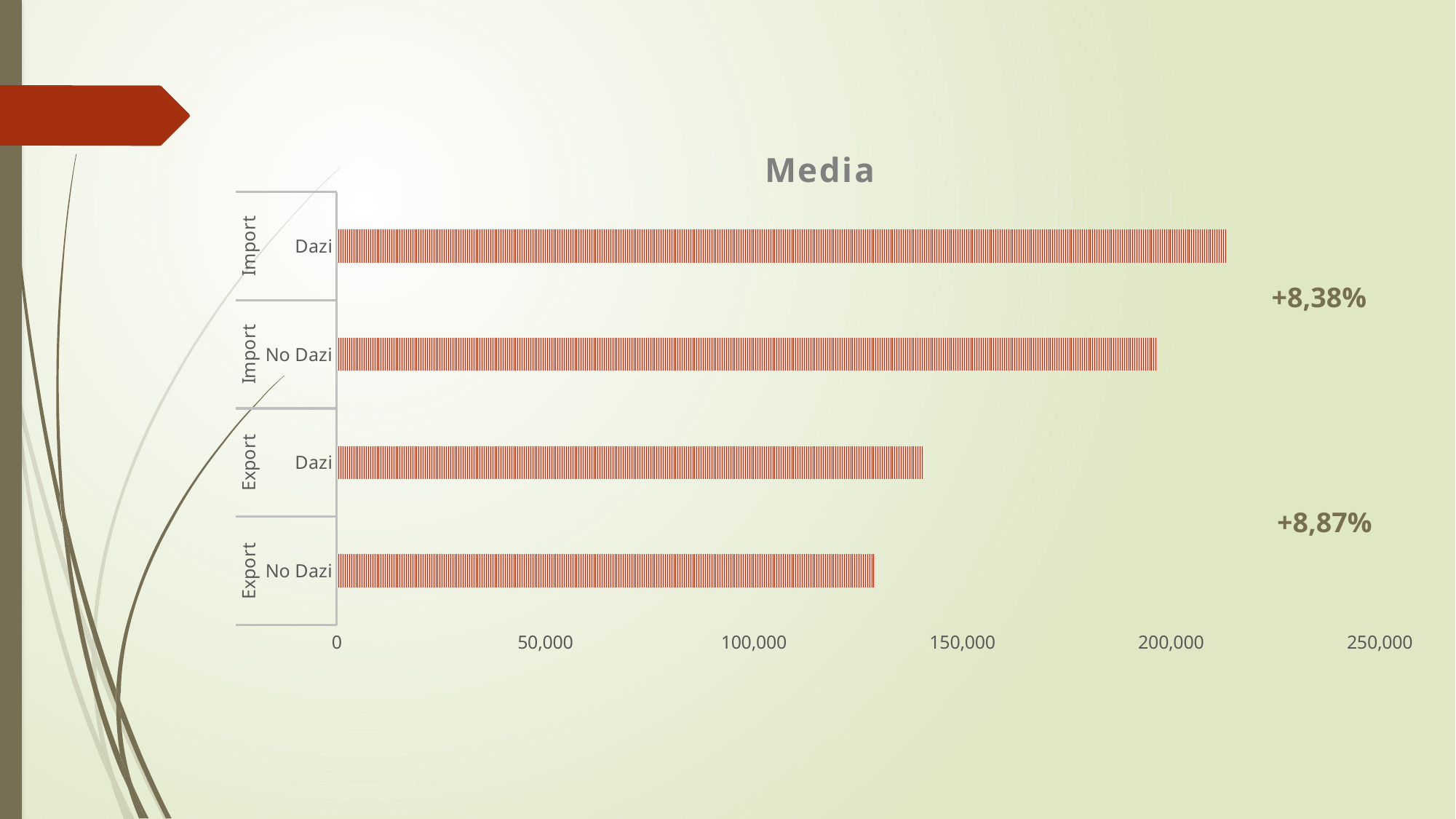
What is the title of the chart? Media Which category has the highest value? Import Dazi Which is larger, the value for Export Dazi or the value for Export No Dazi? Export Dazi How many bars are plotted in the chart? 4 What kind of chart is shown on the slide? bar chart Is the value for Export Dazi greater or less than 150,000? less What percentage change is annotated next to the Export bars? +8,87% Is the value for Export No Dazi greater or less than 100,000? greater Which is larger, the value for Import Dazi or the value for Import No Dazi? Import Dazi Is the value for Import Dazi greater or less than 200,000? greater Which category has the lowest value? Export No Dazi